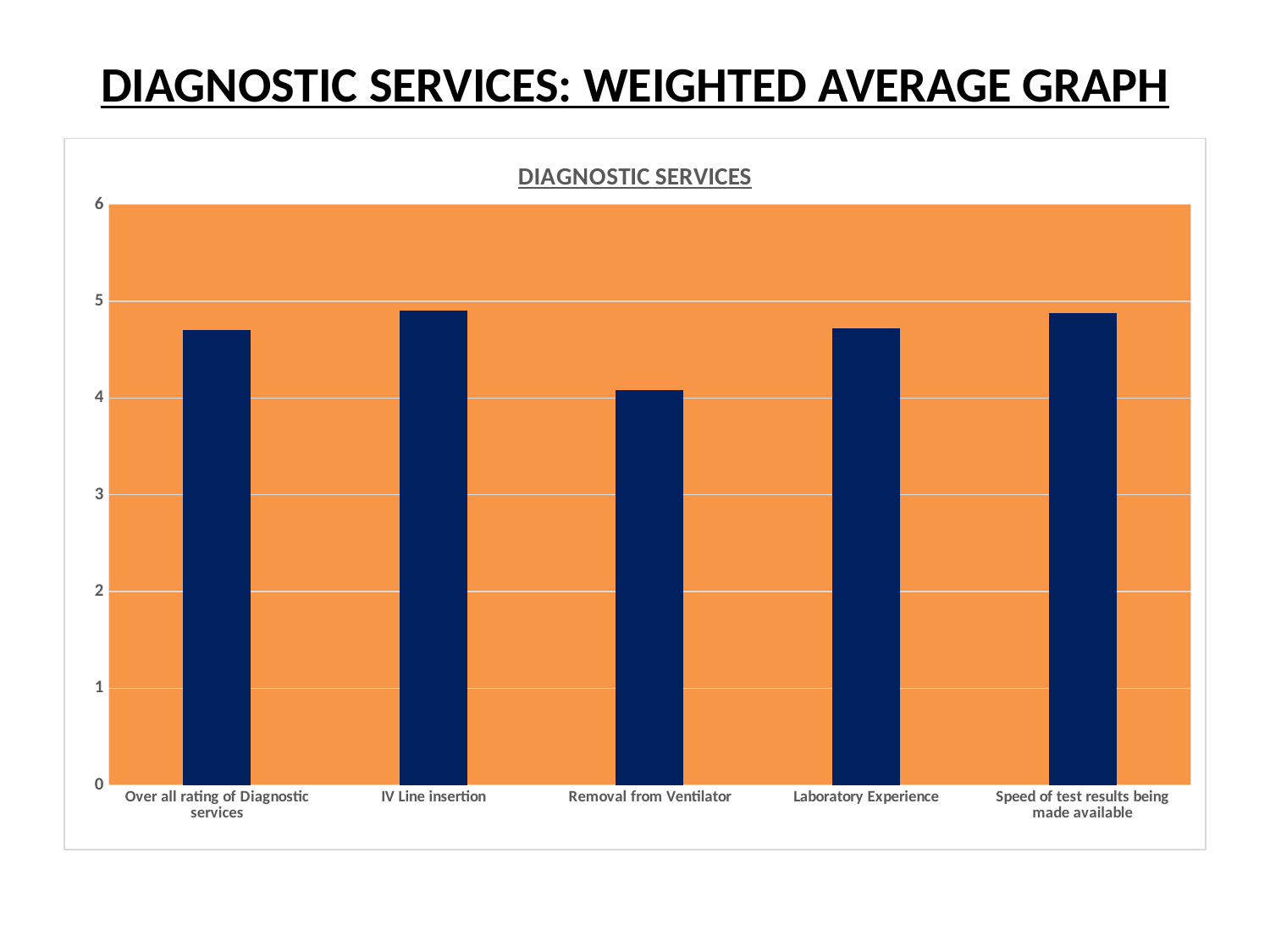
Is the value for Removal from Ventilator greater or less than 5? less What is the title of the chart? DIAGNOSTIC SERVICES What kind of chart is shown on the slide? bar chart Is the value for IV Line insertion greater or less than 4? greater Is the value for IV Line insertion greater or less than 5? less Which is larger, the value for Over all rating of Diagnostic services or the value for Removal from Ventilator? Over all rating of Diagnostic services Which is larger, the value for IV Line insertion or the value for Removal from Ventilator? IV Line insertion Which category has the lowest value in the chart? Removal from Ventilator How many categories are plotted in the chart? 5 Which is larger, the value for Removal from Ventilator or the value for Speed of test results being made available? Speed of test results being made available What is the highest value shown on the vertical axis of the chart? 6